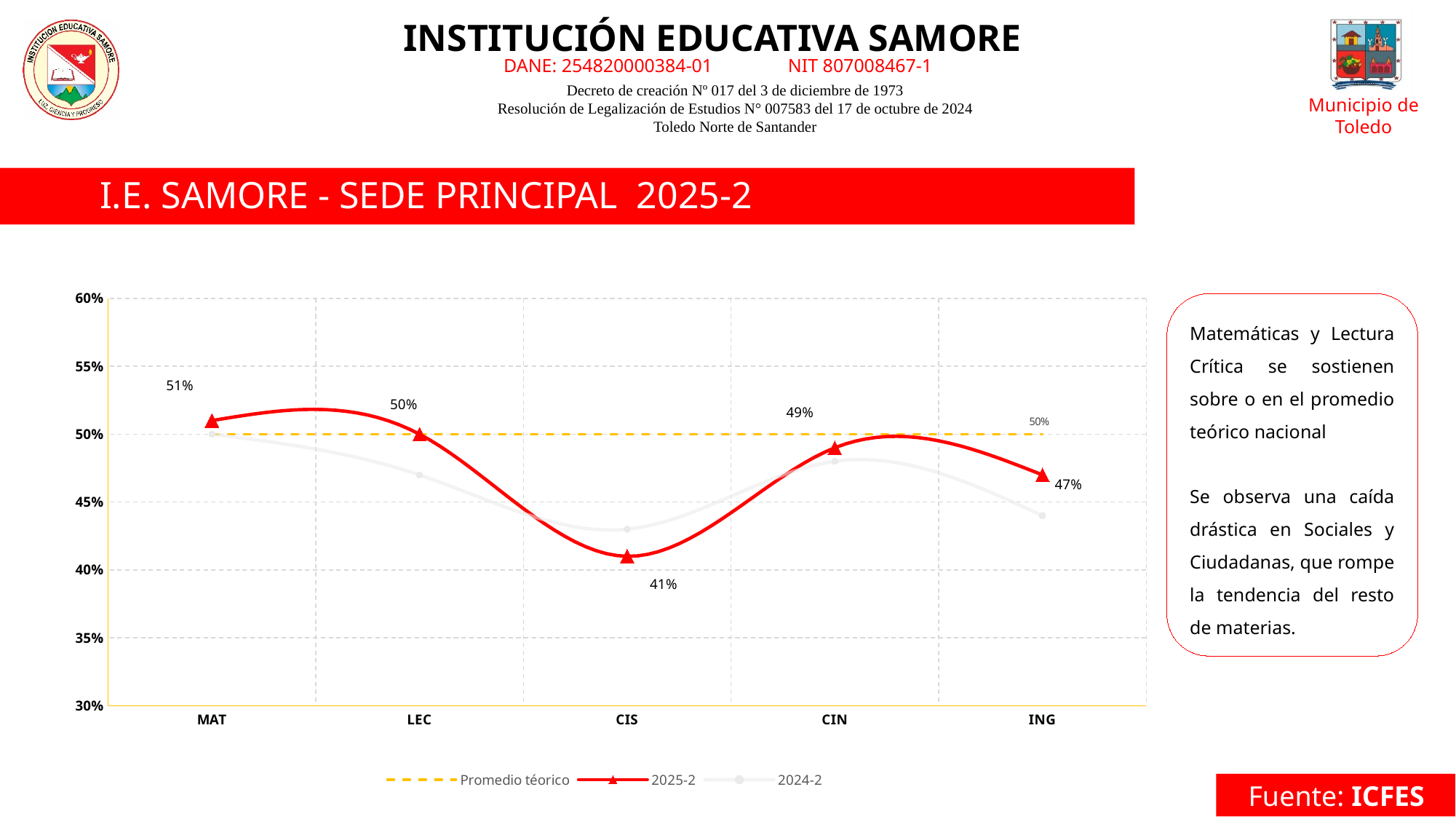
What is the 2025-2 value for ING? 47% What is the 2025-2 value for CIS? 41% Is the 2024-2 value for CIS greater or less than 45%? less Which category has the lowest 2025-2 value? CIS What kind of chart is shown on the slide? line chart Which category has the highest 2025-2 value? MAT How many series does the legend list? 3 Does the 2025-2 series rise or fall from CIS to CIN? rise How many categories are shown on the x axis? 5 What is the difference between the 2025-2 values for MAT and CIS? 10% What is the 2025-2 value for MAT? 51% Which has the larger 2025-2 value, CIN or ING? CIN